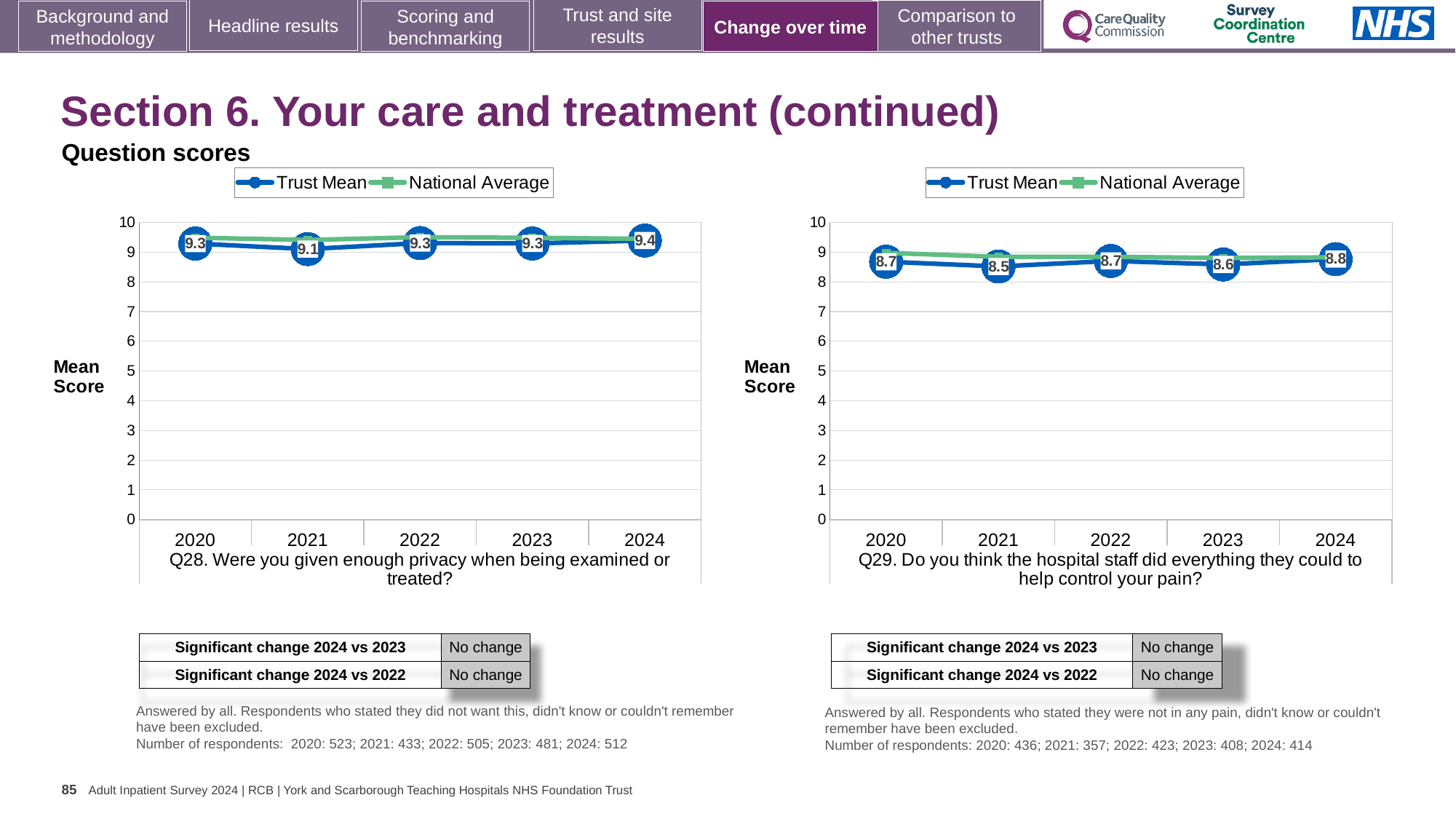
In the Q29 chart on the right, what is the Trust Mean score for 2020? 8.7 In the Q28 chart on the left, is the Trust Mean score for 2022 larger or smaller than the Trust Mean score for 2021? larger What kind of chart is the Q28 chart on the left? Line chart How many years are plotted on the x axis of the Q28 chart on the left? 5 In the Q29 chart on the right, what is the difference between the Trust Mean scores for 2024 and 2021? 0.3 How many series does the legend of the Q29 chart on the right list? 2 In the Q29 chart on the right, is the National Average value for 2020 greater or less than 8? greater In the Q28 chart on the left, what is the Trust Mean score for 2024? 9.4 In the Q28 chart on the left, which year has the highest Trust Mean score? 2024 In the Q29 chart on the right, does the Trust Mean score rise or fall from 2023 to 2024? rise In the Q29 chart on the right, which year has the lowest Trust Mean score? 2021 In the Q28 chart on the left, what is the Trust Mean score for 2021? 9.1